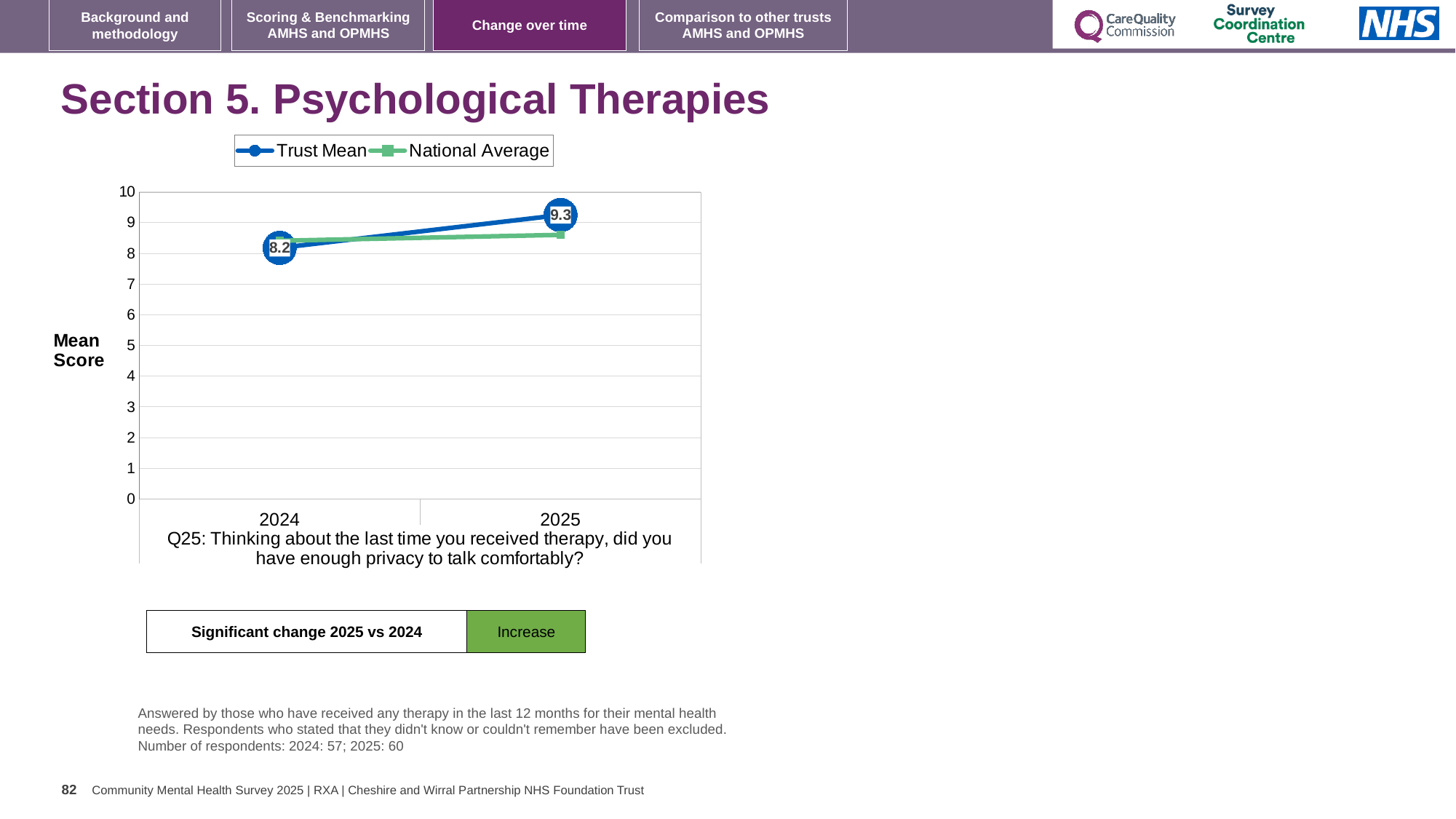
What is the Trust Mean value for 2024? 8.2 In which year is the Trust Mean highest? 2025 How many years are shown on the x axis? 2 What kind of chart is shown on the slide? line chart What is the Trust Mean value for 2025? 9.3 In 2025, which is larger: the Trust Mean or the National Average? Trust Mean How many series does the legend list? 2 Is the National Average value for 2025 greater or less than 9? less Is the National Average value for 2024 greater or less than 8? greater In which year is the Trust Mean lowest? 2024 Does the Trust Mean rise or fall from 2024 to 2025? rise By how much did the Trust Mean change from 2024 to 2025? 1.1